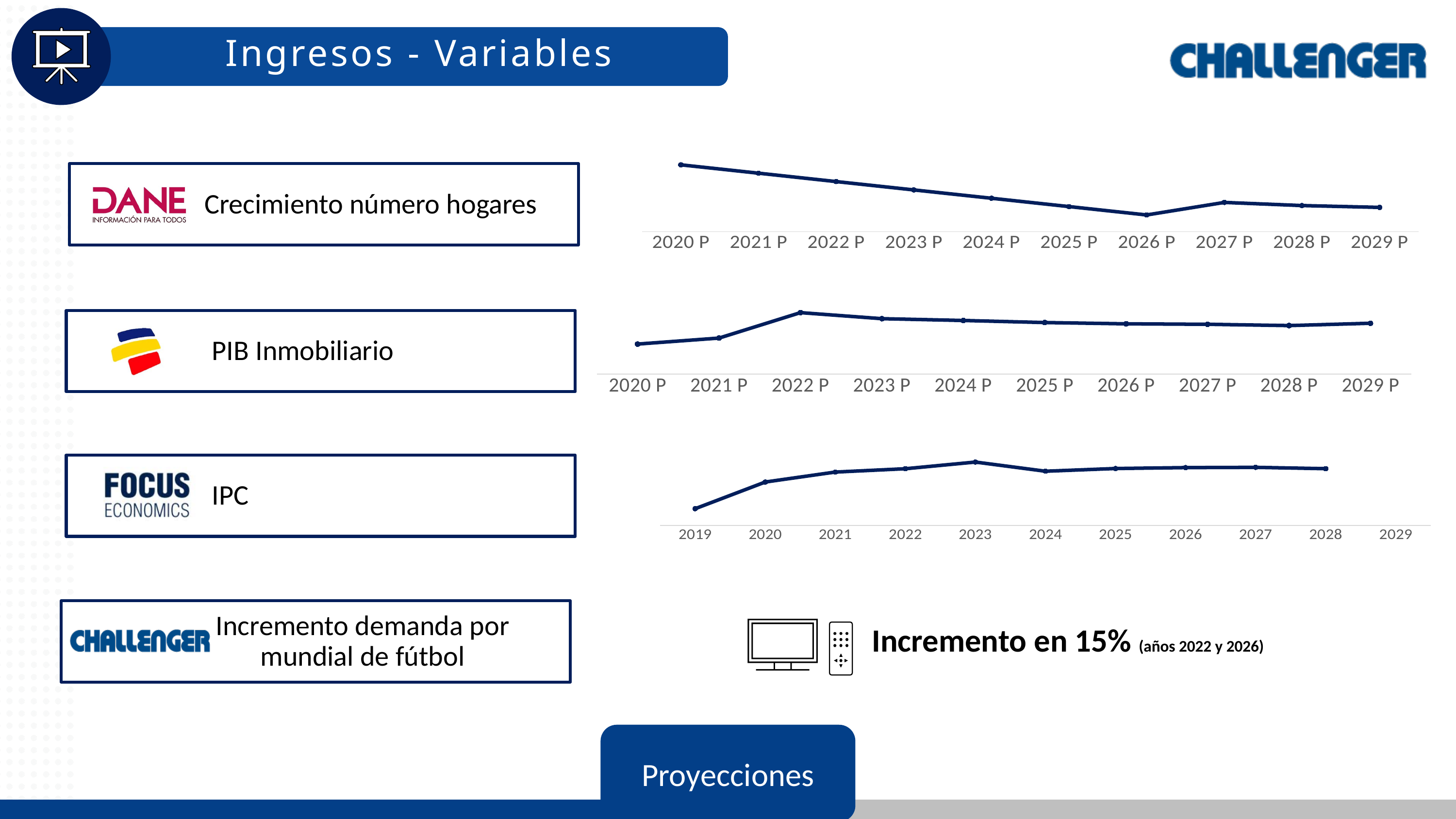
In the PIB Inmobiliario chart, which year has the highest value? 2022 P In the IPC chart, do the values rise or fall from 2019 to 2023? rise In the IPC chart, which year has the highest value? 2023 In the PIB Inmobiliario chart, is the value for 2021 P higher or lower than the value for 2022 P? lower In the Crecimiento número hogares chart, which year has the highest value? 2020 P In the IPC chart, which year has the lowest value? 2019 In the PIB Inmobiliario chart, which year has the lowest value? 2020 P In the Crecimiento número hogares chart, which year has the lowest value? 2026 P How many data points are plotted in the Crecimiento número hogares chart? 10 What kind of chart is used for Crecimiento número hogares? line chart How many data points are plotted in the PIB Inmobiliario chart? 10 In the Crecimiento número hogares chart, do the values generally rise or fall from 2020 P to 2026 P? fall